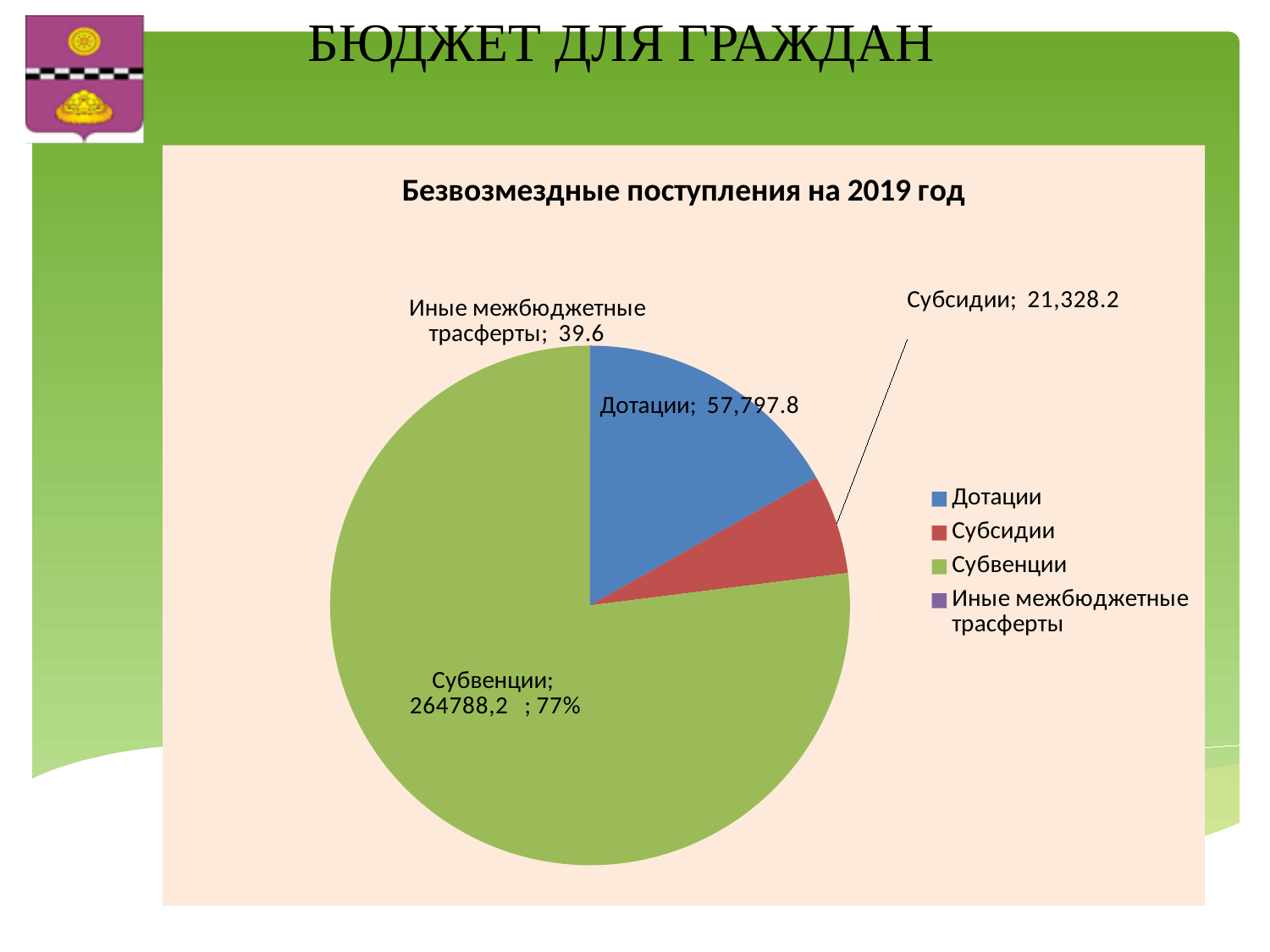
What is the value for Иные межбюджетные трасферты? 39.6 What type of chart is shown on the slide? Pie chart What is the value for Субвенции? 264788,2 What is the value for Дотации? 57,797.8 Which category has the largest slice of the pie? Субвенции What is the title of the chart? Безвозмездные поступления на 2019 год How many categories does the legend list? 4 Which category has the smallest slice of the pie? Иные межбюджетные трасферты What is the value for Субсидии? 21,328.2 Which is larger, Дотации or Субсидии? Дотации What is the difference between the values for Дотации and Субсидии? 36,469.6 What share of the pie does Субвенции represent? 77%